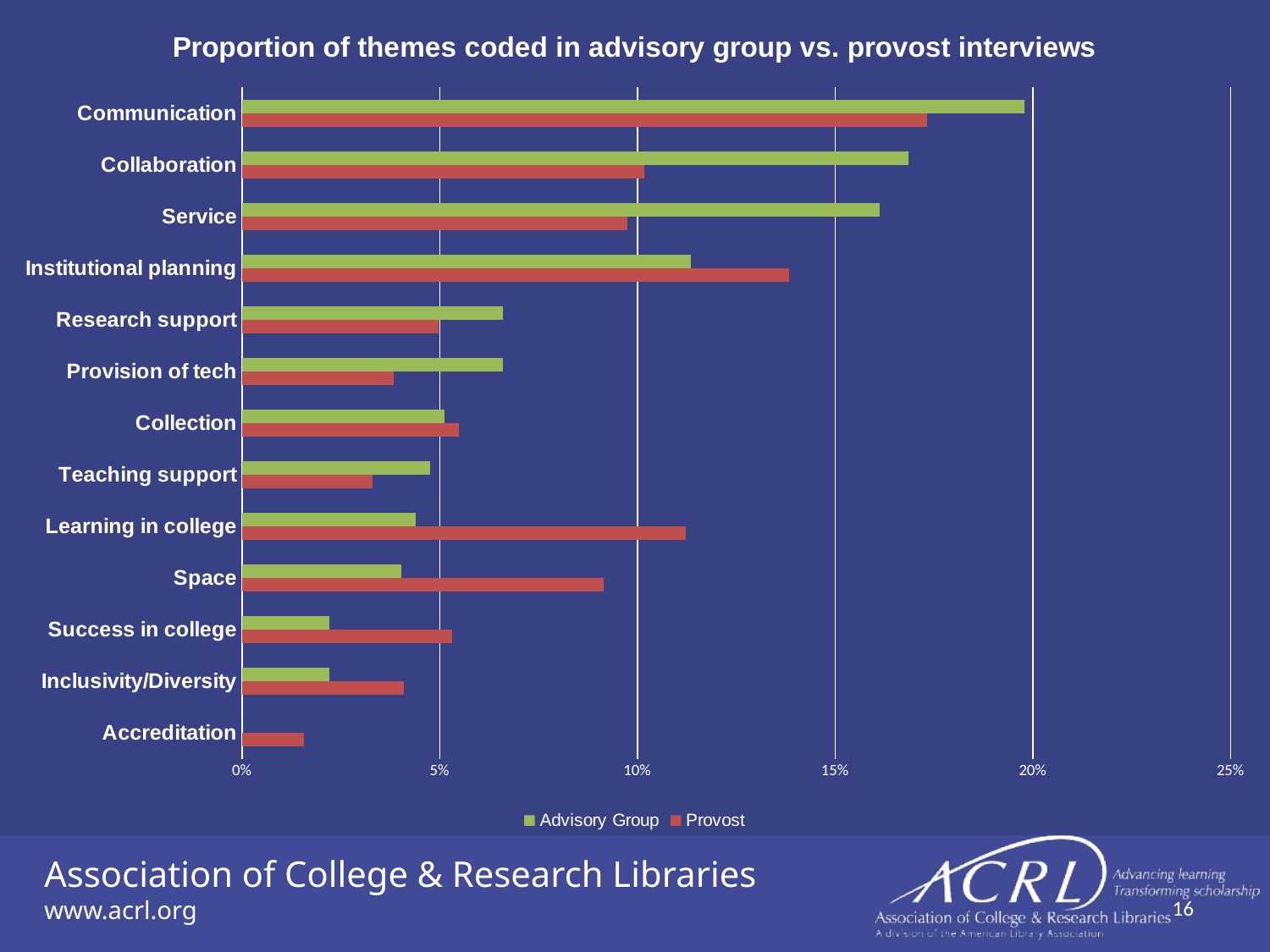
Is the Advisory Group value for Communication greater or less than 15%? greater Is the Provost value for Teaching support greater or less than 5%? less Which theme has the highest Advisory Group proportion? Communication What kind of chart is shown on the slide? bar chart Which theme has the lowest Provost proportion? Accreditation How many series does the legend list? 2 Is the Provost value for Institutional planning greater or less than 10%? greater For Collaboration, which series has the larger value, Advisory Group or Provost? Advisory Group For Learning in college, which series has the larger value, Advisory Group or Provost? Provost How many themes (categories) are listed on the chart? 13 Which theme has the highest Provost proportion? Communication